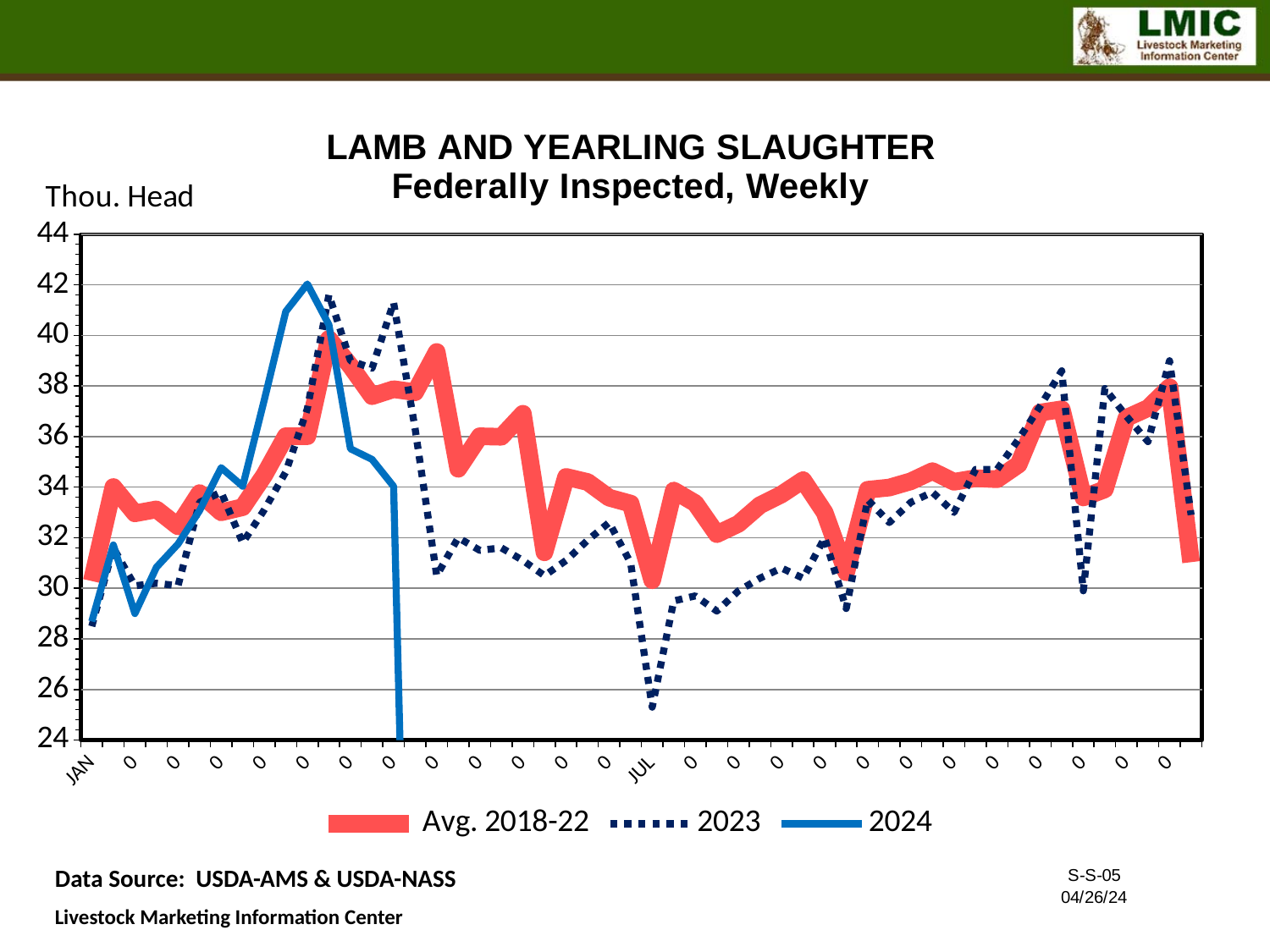
What kind of chart is shown on the slide? line chart Is the value of the Avg. 2018-22 line at JAN greater or less than 32? less Is the peak value of the 2024 line greater or less than 40? greater Is the value of the 2023 line at JAN greater or less than 30? less What unit is shown on the y axis of the chart? Thou. Head Does the 2024 line generally rise or fall from JAN to its peak? rise What are the three series listed in the legend? Avg. 2018-22, 2023, 2024 How many series does the legend list? 3 At JAN, which is larger: the Avg. 2018-22 line or the 2024 line? Avg. 2018-22